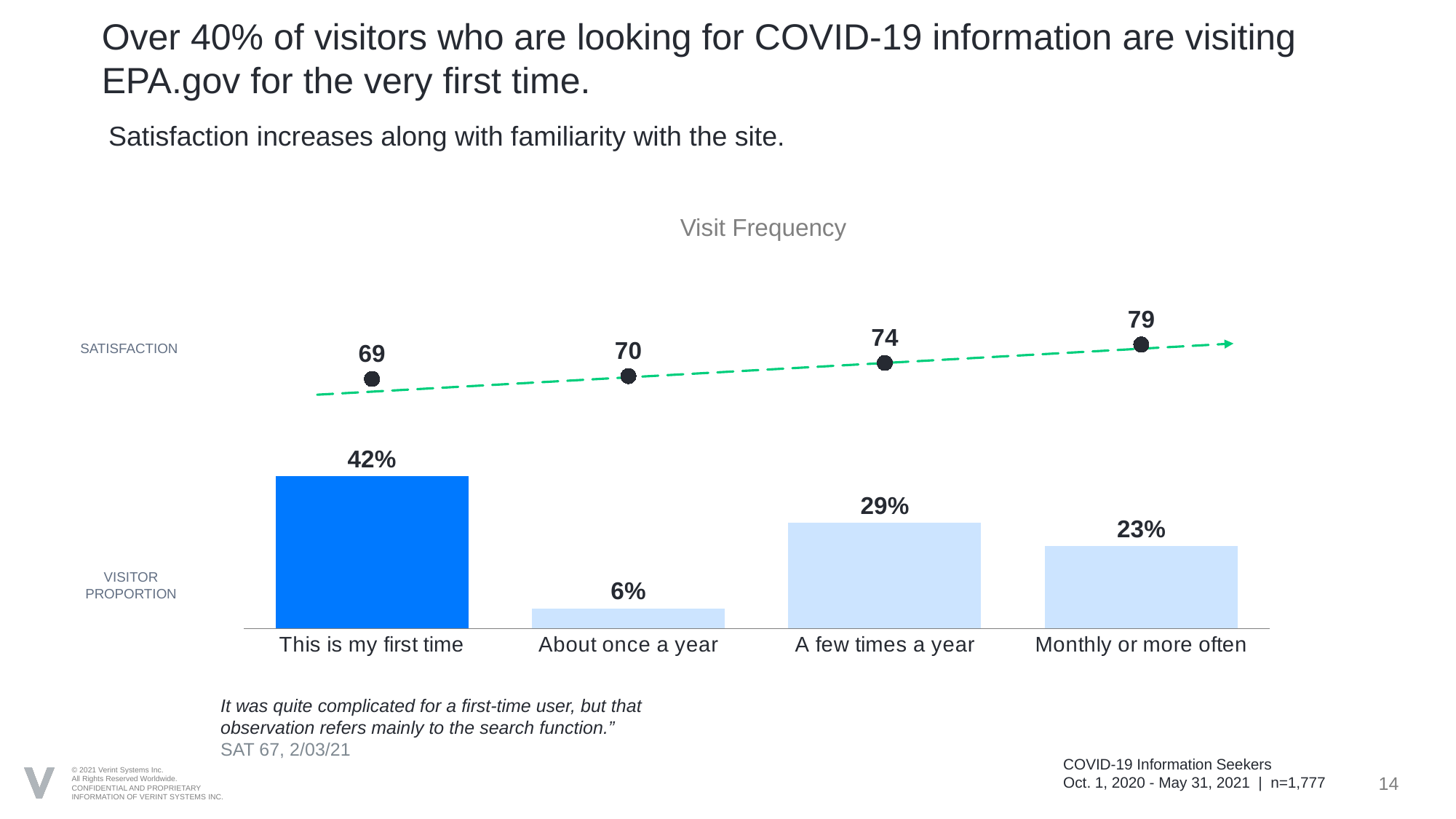
Which visit frequency category has the highest visitor proportion? This is my first time What is the visitor proportion for 'This is my first time'? 42% What is the visitor proportion for 'About once a year'? 6% How many visit frequency categories are shown on the chart? 4 What is the difference in visitor proportion between 'A few times a year' and 'Monthly or more often'? 6% What is the satisfaction score for 'A few times a year'? 74 What is the satisfaction score for 'Monthly or more often'? 79 What is the title of the chart? Visit Frequency Does satisfaction rise or fall as visit frequency increases from left to right? Rise Which visit frequency category has the lowest satisfaction score? This is my first time Which has a larger visitor proportion, 'About once a year' or 'Monthly or more often'? Monthly or more often What is the difference in satisfaction between 'Monthly or more often' and 'This is my first time'? 10